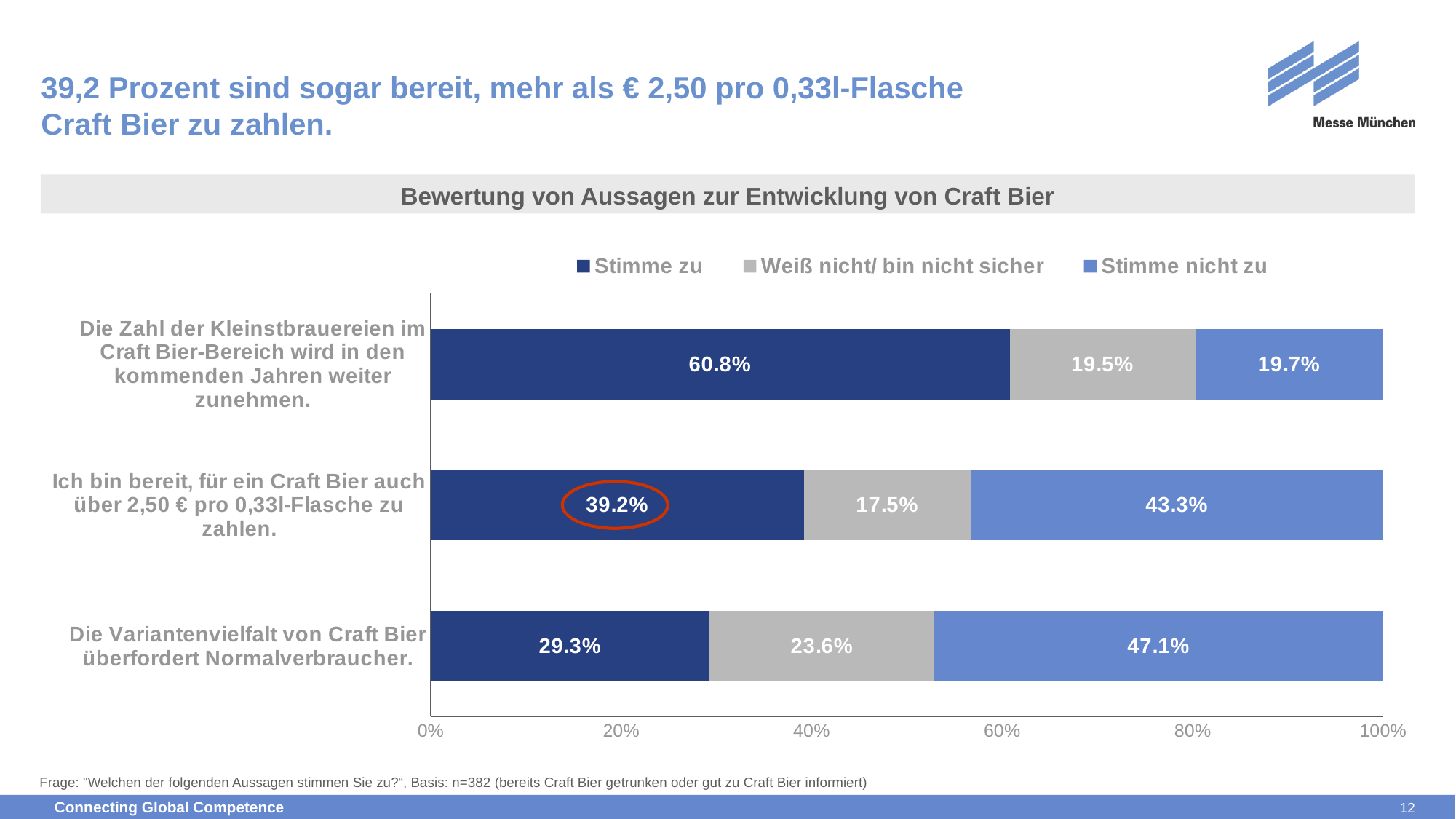
What is the title of the chart? Bewertung von Aussagen zur Entwicklung von Craft Bier What is the "Weiß nicht/ bin nicht sicher" value for the statement "Die Variantenvielfalt von Craft Bier überfordert Normalverbraucher."? 23.6% What kind of chart is shown on the slide? Stacked bar chart What is the difference between the "Stimme nicht zu" and "Stimme zu" values for the statement "Die Variantenvielfalt von Craft Bier überfordert Normalverbraucher."? 17.8% Which statement has the lowest "Stimme nicht zu" share? Die Zahl der Kleinstbrauereien im Craft Bier-Bereich wird in den kommenden Jahren weiter zunehmen. How many series does the legend list? 3 What is the "Stimme nicht zu" value for the statement "Ich bin bereit, für ein Craft Bier auch über 2,50 € pro 0,33l-Flasche zu zahlen."? 43.3% For the statement "Ich bin bereit, für ein Craft Bier auch über 2,50 € pro 0,33l-Flasche zu zahlen.", which is larger: "Stimme zu" or "Stimme nicht zu"? Stimme nicht zu Which statement has the highest "Stimme zu" share? Die Zahl der Kleinstbrauereien im Craft Bier-Bereich wird in den kommenden Jahren weiter zunehmen. Which value on the chart is circled in red? 39.2% What percentage of respondents answered "Stimme zu" to the statement "Die Zahl der Kleinstbrauereien im Craft Bier-Bereich wird in den kommenden Jahren weiter zunehmen."? 60.8% How many statements (categories) are shown in the chart? 3